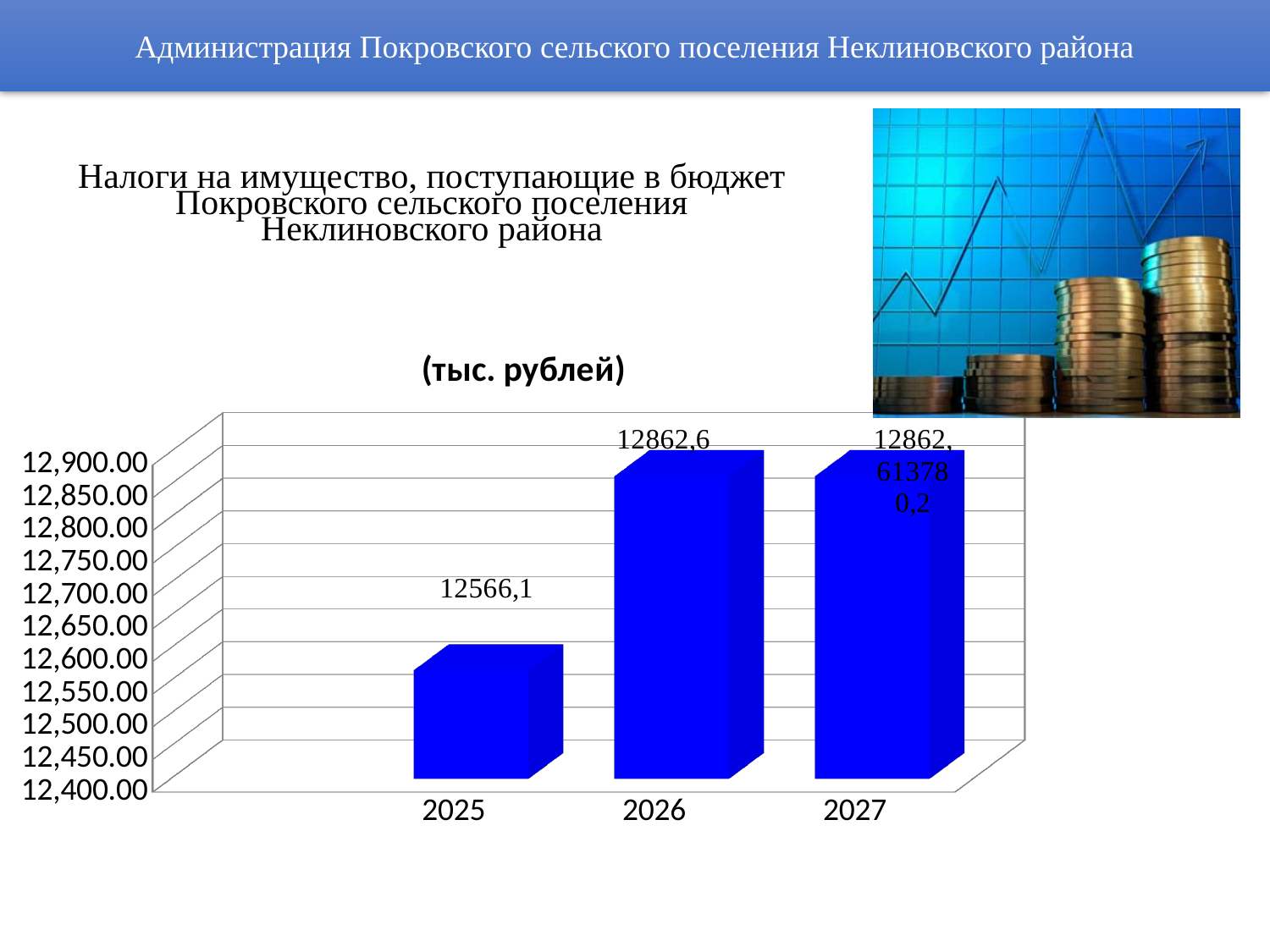
What is the difference between the values for 2026 and 2025? 296,5 Is the value for 2025 greater or less than 12,600.00? less Do the values rise or fall from 2025 to 2026? rise What is the title shown above the chart? (тыс. рублей) What colour are the bars in the chart? blue What kind of chart is shown on the slide? bar chart Which year has the lowest value on the chart? 2025 Which is larger, the value for 2025 or the value for 2026? 2026 How many years are shown on the x axis of the chart? 3 Is the value for 2027 greater or less than 12,800.00? greater What is the value for 2025 on the chart? 12566,1 What is the value for 2026 on the chart? 12862,6